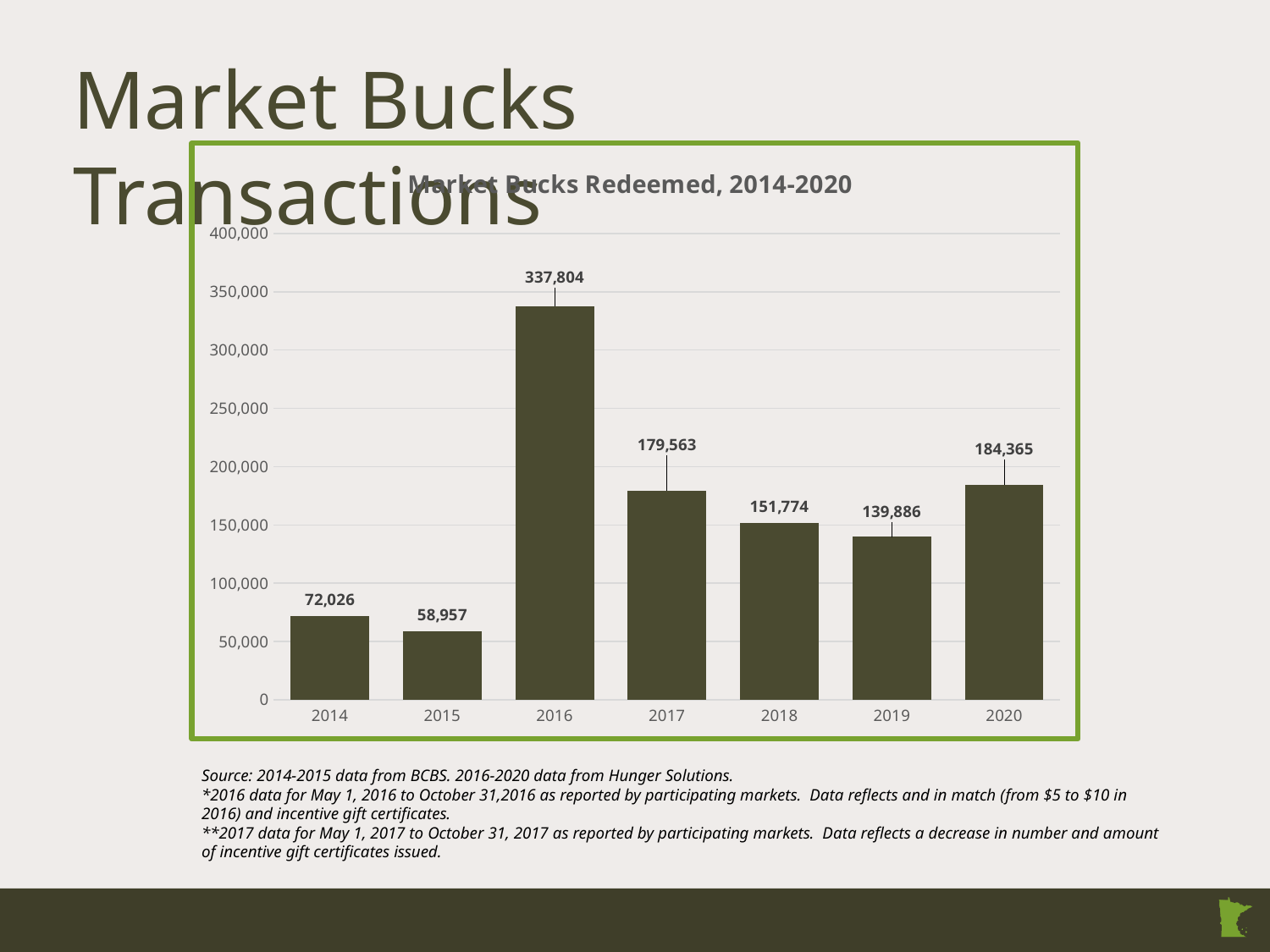
Which year has the highest value? 2016 Do the values rise or fall from 2016 to 2019? fall What is the difference between the values for 2020 and 2019? 44,479 Which year has the lowest value? 2015 Is the value for 2019 greater or less than 150,000? less What value is shown for 2020? 184,365 What is the difference between the values for 2016 and 2015? 278,847 How many years are shown on the x axis? 7 What value is shown for 2016? 337,804 Which is larger, the value for 2017 or the value for 2018? 2017 What kind of chart is this? bar chart What value is shown for 2014? 72,026